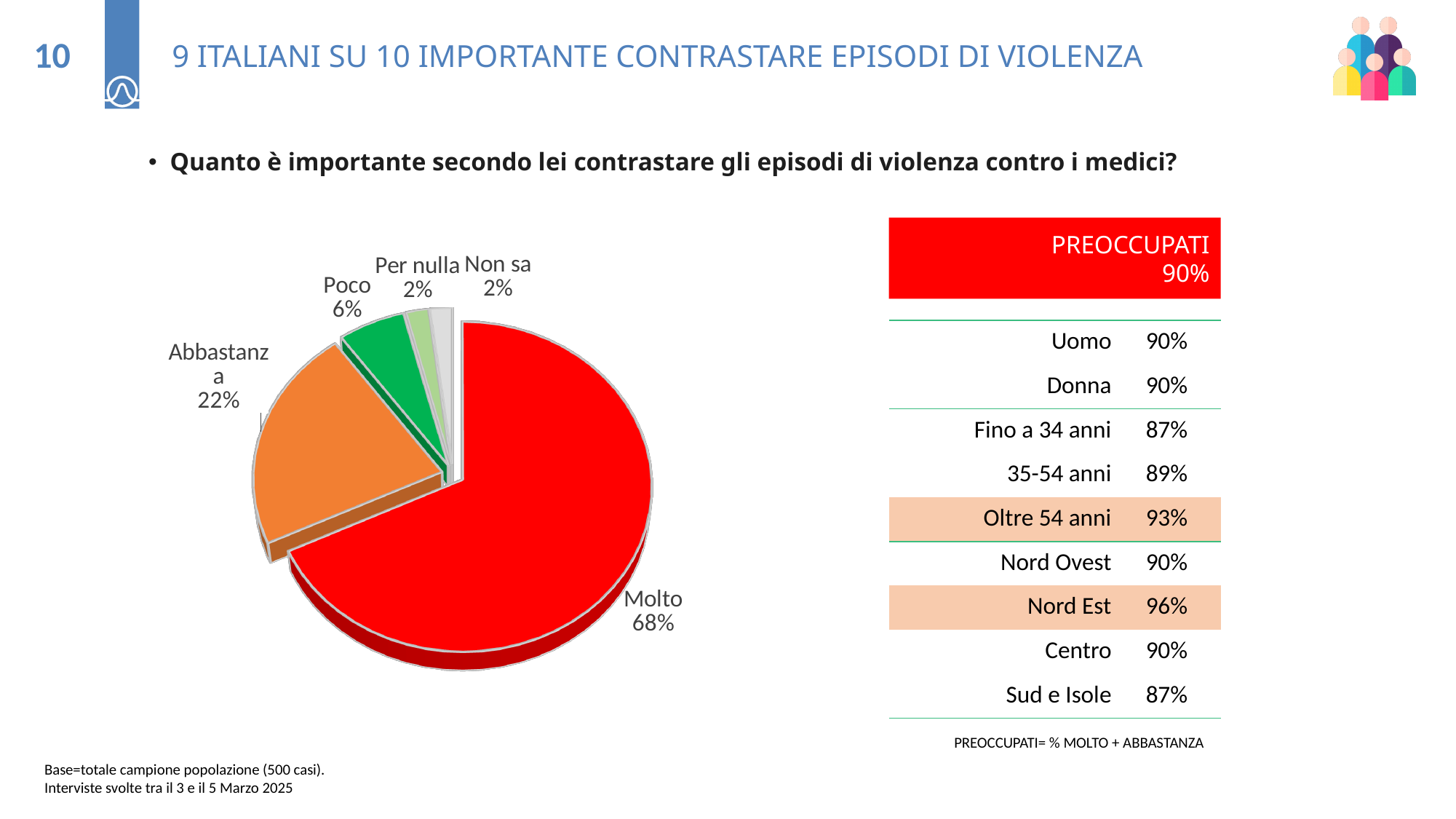
What type of chart is used on this slide? Pie chart What percentage does the "Poco" slice represent in the pie chart? 6% Which slice is larger in the pie chart, "Abbastanza" or "Poco"? Abbastanza What colour is the "Molto" slice in the pie chart? Red What is the difference in percentage points between the "Molto" and "Abbastanza" slices? 46% How many categories are shown in the pie chart? 5 What is the value shown for "Non sa" in the pie chart? 2% What is the value shown for "Per nulla" in the pie chart? 2% What percentage of respondents answered "Molto" in the pie chart? 68% What is the value of the "Abbastanza" slice in the pie chart? 22% What is the combined share of the "Molto" and "Abbastanza" slices in the pie chart? 90% Which category has the largest slice in the pie chart? Molto